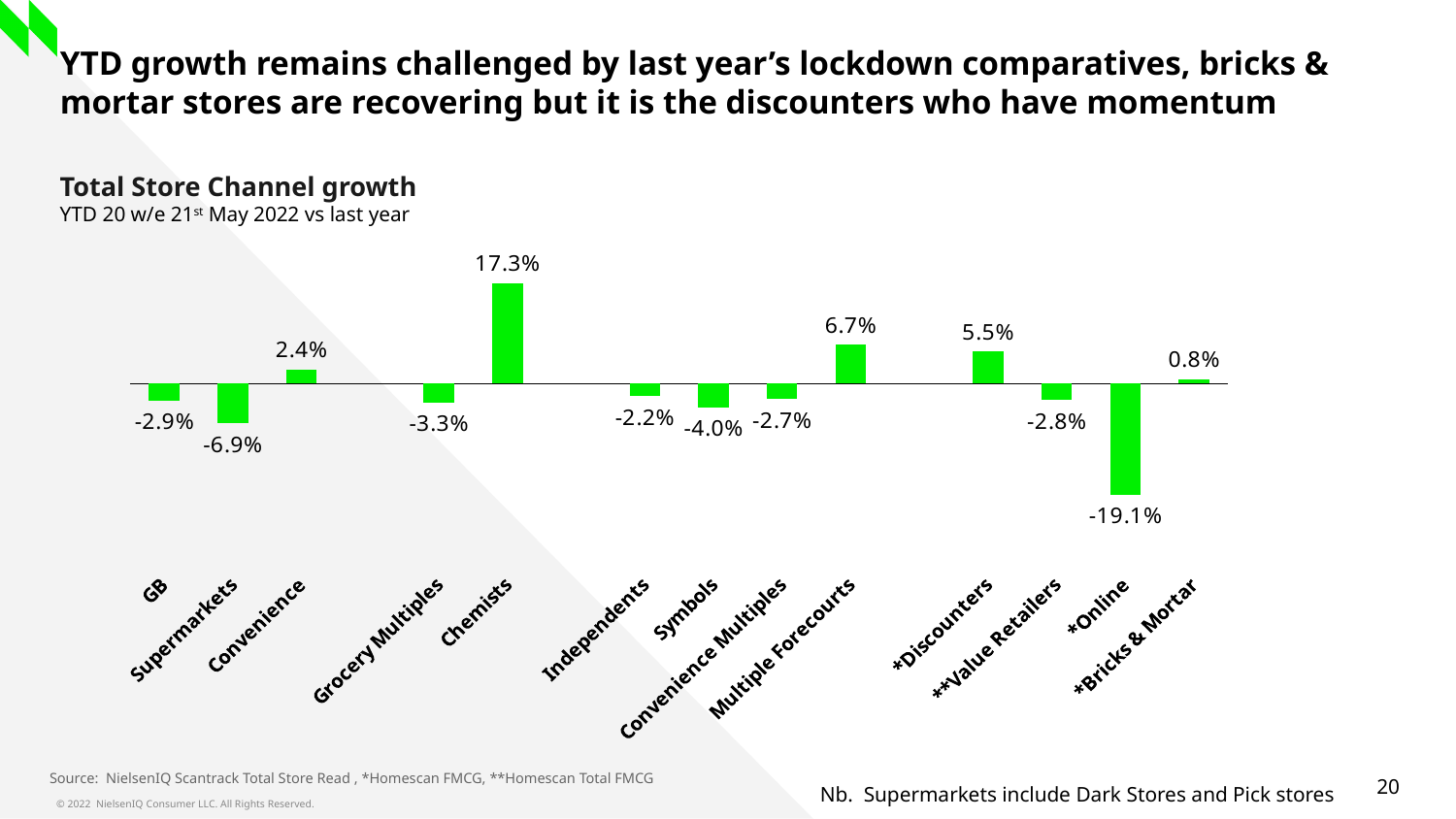
What type of chart is shown on the slide? Bar chart Which has a higher growth value, Convenience or Multiple Forecourts? Multiple Forecourts What is the growth value for Chemists? 17.3% What is the title of the chart? Total Store Channel growth What is the growth value for GB? -2.9% What is the growth value for *Discounters? 5.5% Which channel has the lowest growth value? *Online What is the growth value for *Online? -19.1% How many channels are shown in the chart? 13 What is the difference between the growth values for Chemists and Multiple Forecourts? 10.6 percentage points What is the growth value for Supermarkets? -6.9% Which channel has the highest growth value? Chemists